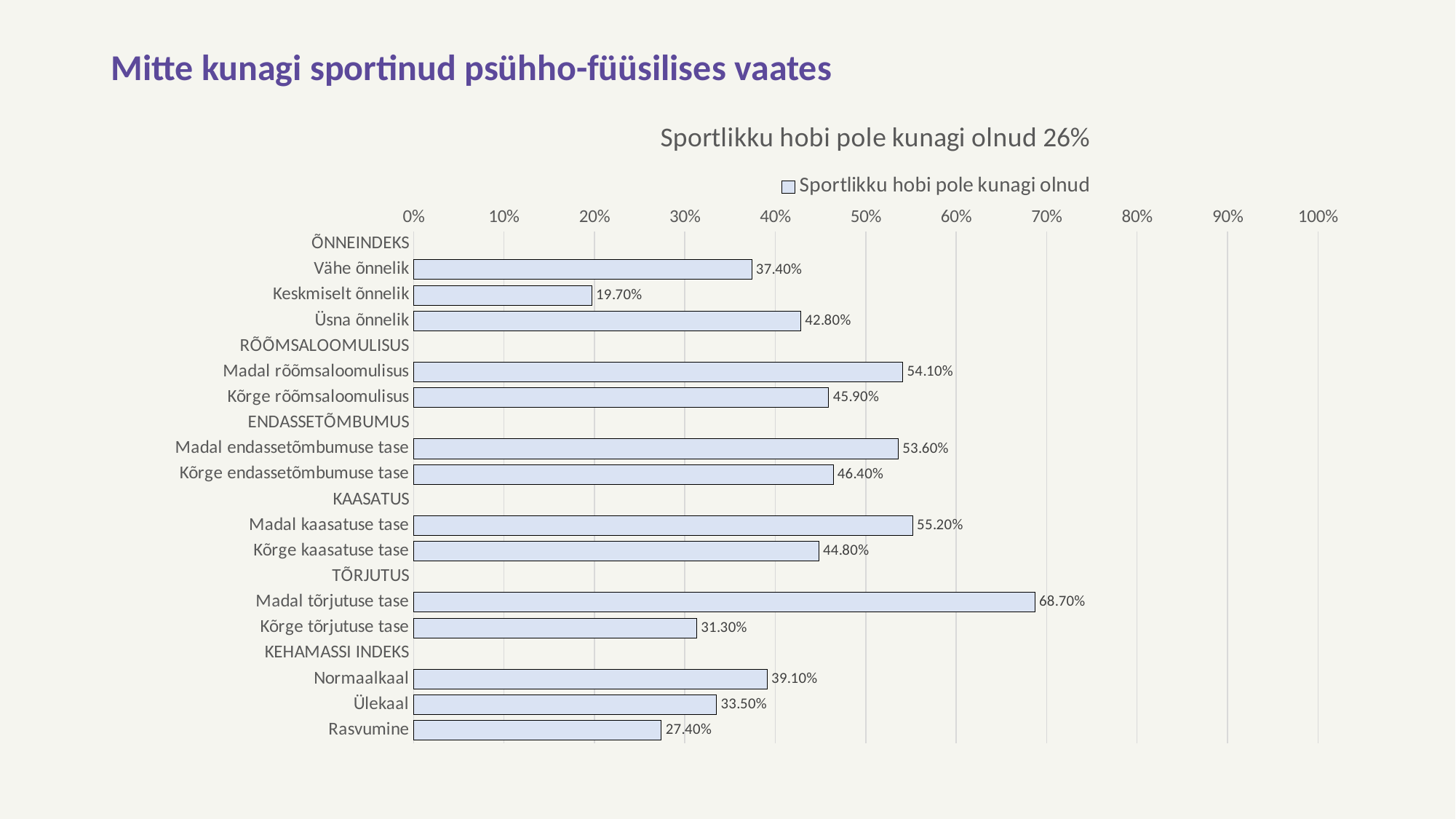
What is the difference between Madal kaasatuse tase and Kõrge kaasatuse tase? 10.40% What is the value for Rasvumine? 27.40% Which category has the highest value? Madal tõrjutuse tase What is the value for Keskmiselt õnnelik? 19.70% What kind of chart is shown? bar chart Which is larger, Normaalkaal or Ülekaal? Normaalkaal Which category has the lowest value? Keskmiselt õnnelik How many bars are plotted in the chart? 15 Is the value for Kõrge tõrjutuse tase greater or less than 40%? less What is the value for Madal tõrjutuse tase? 68.70% What is the title of the chart? Sportlikku hobi pole kunagi olnud 26% How many series does the legend list? 1